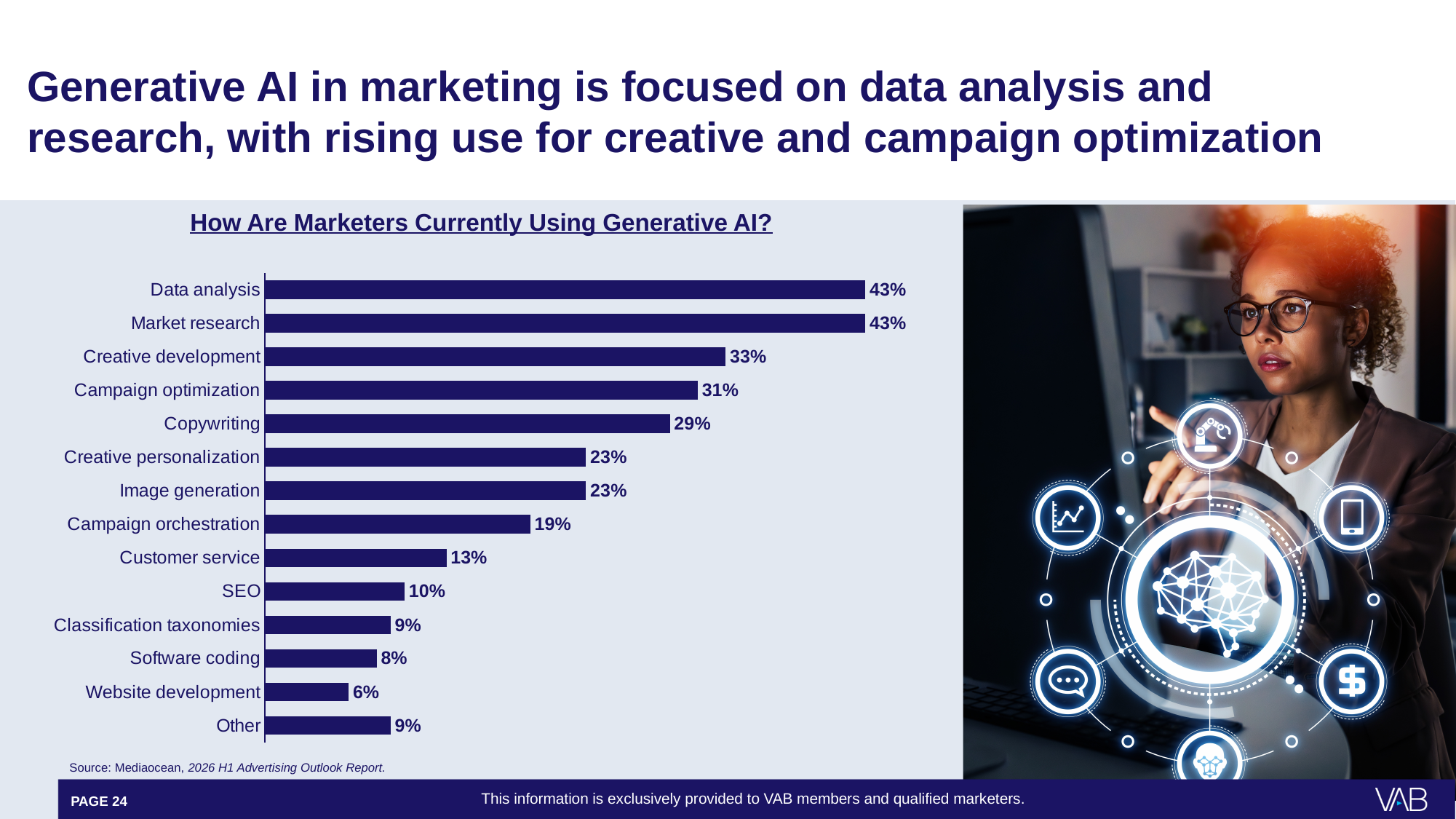
What percentage is shown for Website development? 6% Which is larger, the value for SEO or the value for Software coding? SEO Which is larger, Creative personalization or Campaign orchestration? Creative personalization What is the difference between Data analysis and Campaign optimization? 12% What is the value shown for Campaign orchestration? 19% How many categories are shown in the chart? 14 What percentage of marketers use generative AI for Creative development? 33% What type of chart is shown on the slide? Bar chart What is the difference between the values for Copywriting and Customer service? 16% What is the highest value shown in the chart? 43% What is the title of the chart? How Are Marketers Currently Using Generative AI? Which category has the lowest value in the chart? Website development